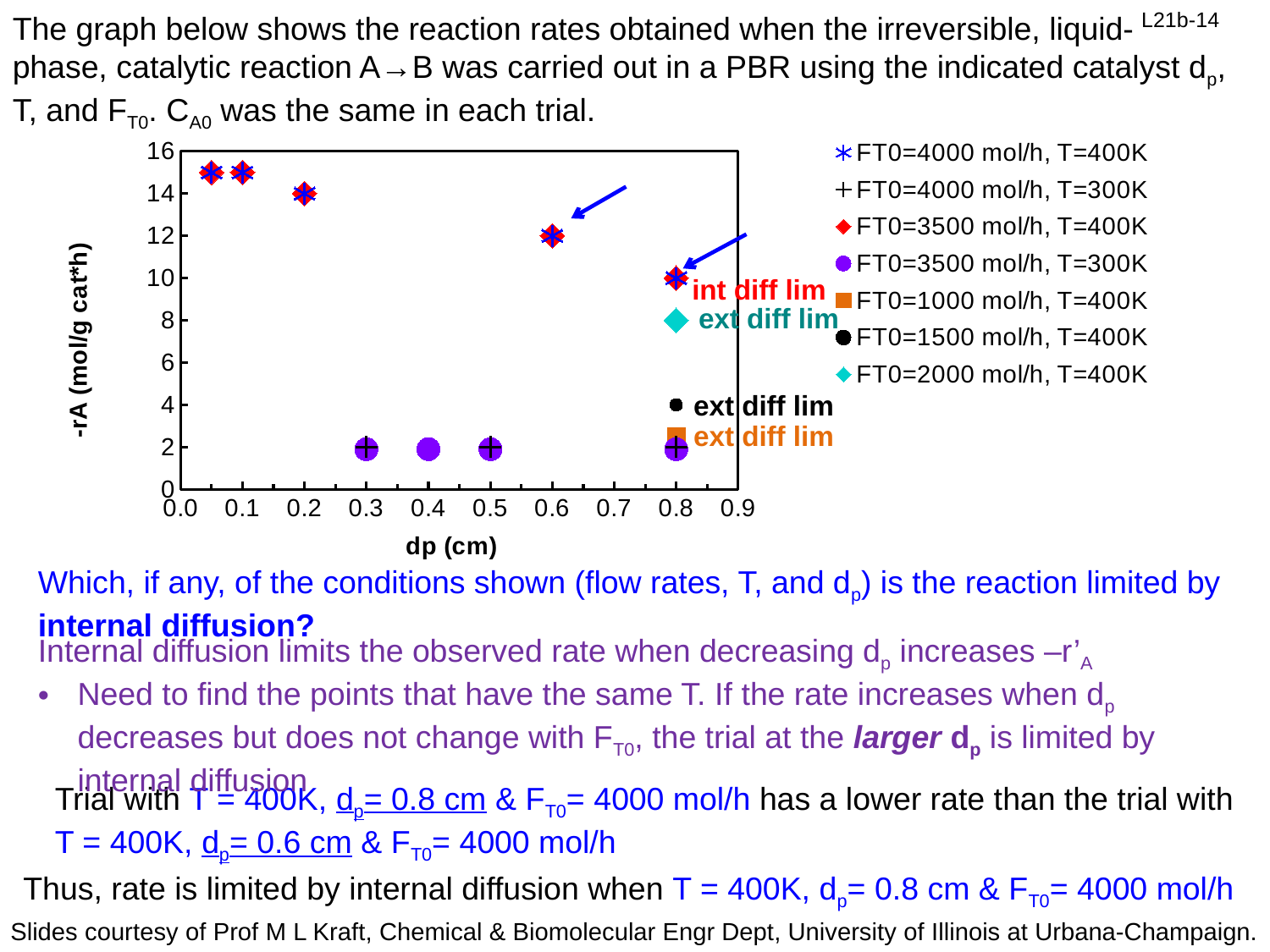
What is the label of the y axis of the chart? -rA (mol/g cat*h) What is the reaction rate -rA at dp = 0.8 cm for the FT0=1500 mol/h, T=400K series? 4 At dp = 0.8 cm, which has the larger reaction rate: the FT0=4000 mol/h, T=400K series or the FT0=2000 mol/h, T=400K series? FT0=4000 mol/h, T=400K Is the reaction rate at dp = 0.1 cm for the FT0=4000 mol/h, T=400K series greater or less than 14? greater What is the reaction rate -rA at dp = 0.2 cm for the FT0=4000 mol/h, T=400K series? 14 How many series does the chart legend list? 7 What is the label of the x axis of the chart? dp (cm) For the T=400K, FT0=4000 mol/h series, does the reaction rate rise or fall as dp increases? fall What kind of chart is shown on the slide? scatter chart What is the reaction rate -rA at dp = 0.6 cm for the FT0=4000 mol/h, T=400K series? 12 What is the reaction rate -rA at dp = 0.8 cm for the FT0=2000 mol/h, T=400K series? 8